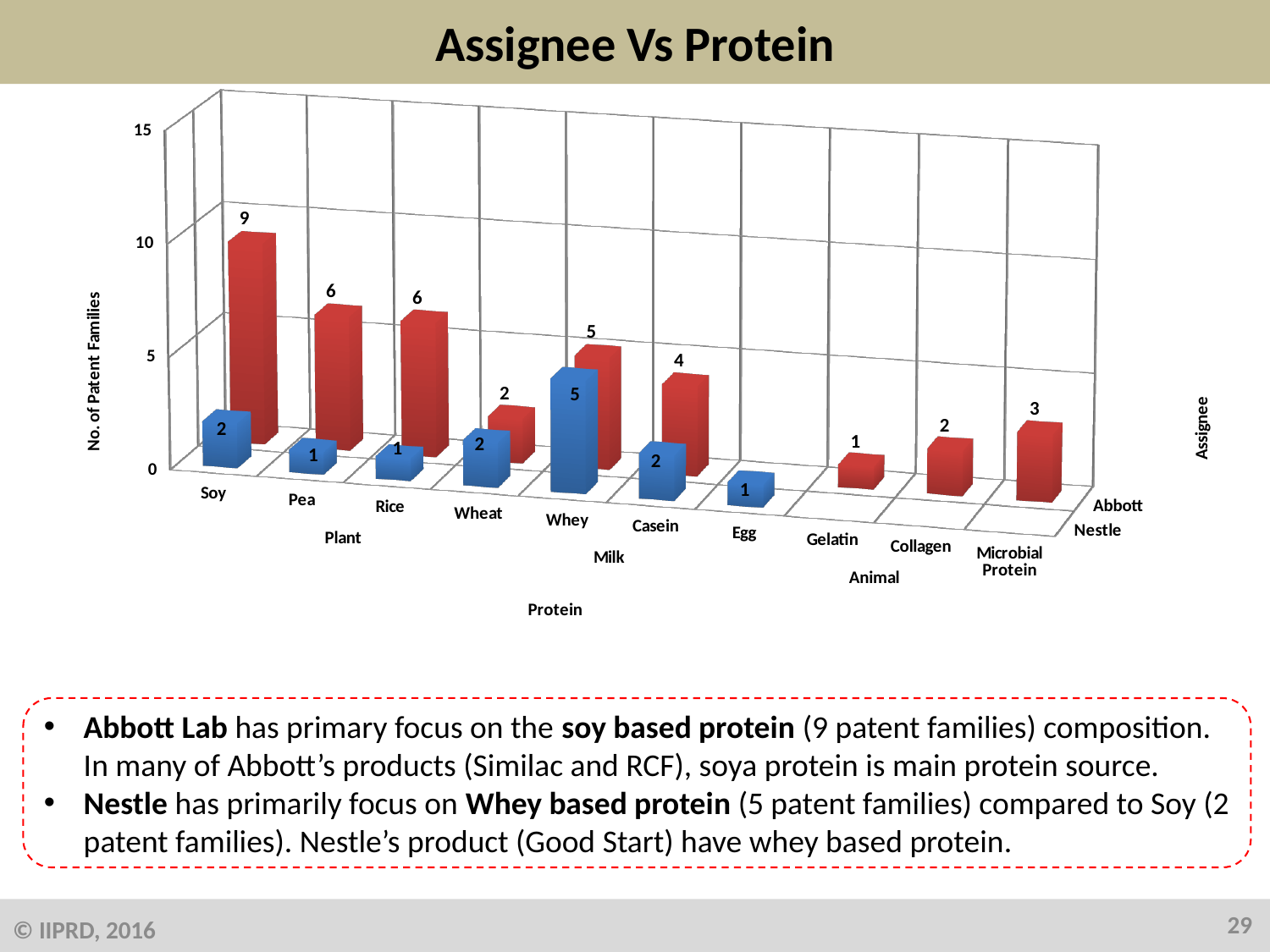
What is the number of patent families for Nestle for Egg? 1 How many protein categories are shown on the x axis? 10 Which protein has the highest number of patent families for Abbott? Soy What kind of chart is shown on the slide? Bar chart Which protein has the highest number of patent families for Nestle? Whey What is the title of the chart's vertical axis? No. of Patent Families What is the number of patent families for Abbott for Soy? 9 What is the number of patent families for Nestle for Whey? 5 How many assignees are plotted in the chart? 2 Which is larger for Casein: Abbott's or Nestle's number of patent families? Abbott What is the number of patent families for Abbott for Microbial Protein? 3 What is the difference between Abbott's and Nestle's number of patent families for Soy? 7